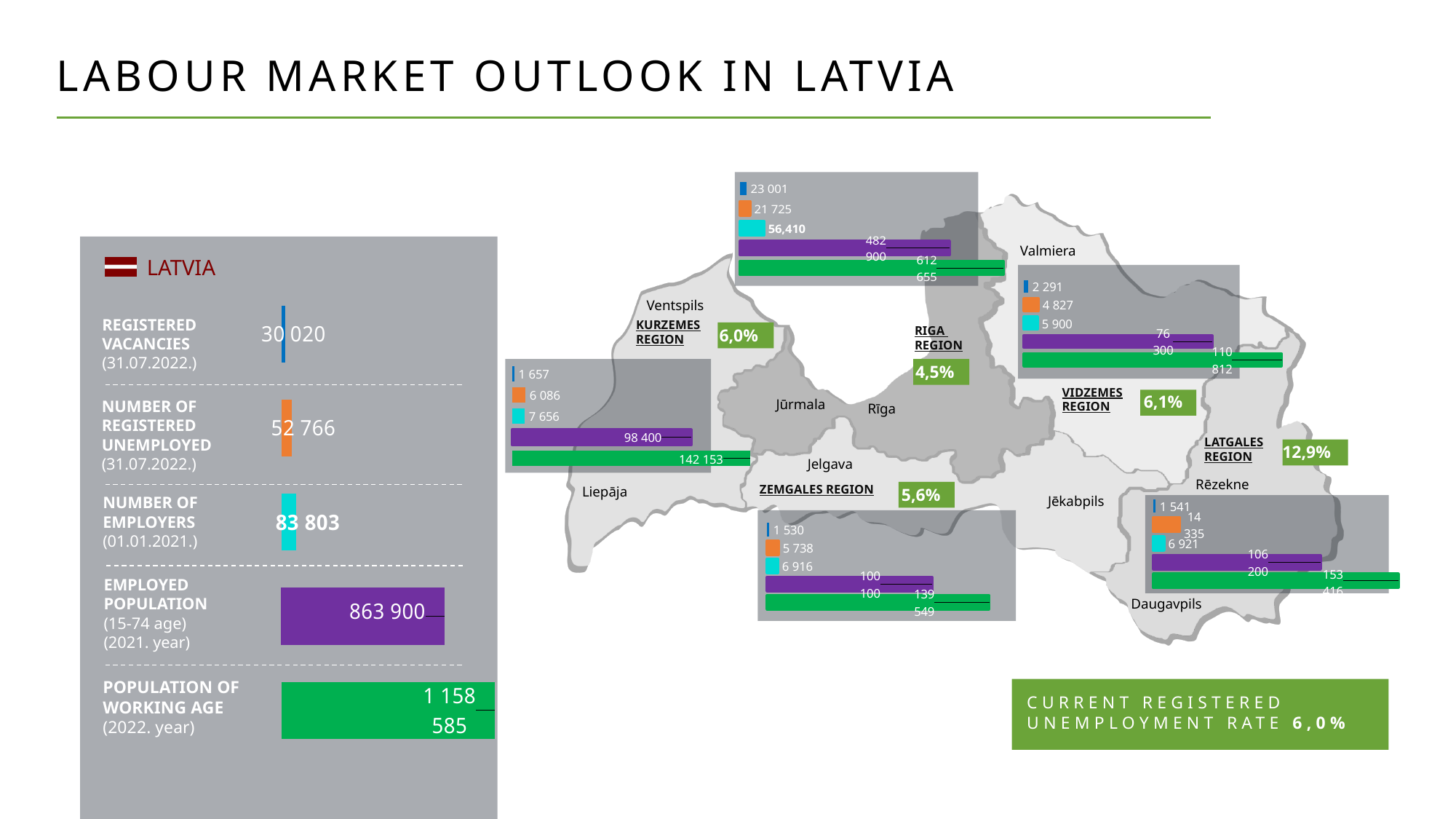
In the LATVIA panel, what is the population of working age (2022. year)? 1 158 585 Which is larger: the employed population (purple bar) in Zemgales region or in Latgales region? Latgales region In the Kurzemes region panel, what is the value of the purple bar (employed population)? 98 400 In the LATVIA panel, what is the number of registered unemployed (31.07.2022.)? 52 766 Which region on the map has the highest registered unemployment rate? Latgales region In the LATVIA panel, what is the number of registered vacancies (31.07.2022.)? 30 020 Which region on the map has the lowest registered unemployment rate? Riga region What is the current registered unemployment rate stated in the green box? 6,0% What is the registered unemployment rate shown for Vidzemes region? 6,1% What is the difference between the number of registered unemployed and the number of registered vacancies in the LATVIA panel? 22 746 In the Riga region panel, what is the value of the green bar (population of working age)? 612 655 In the LATVIA panel, what is the employed population (15-74 age, 2021. year)? 863 900